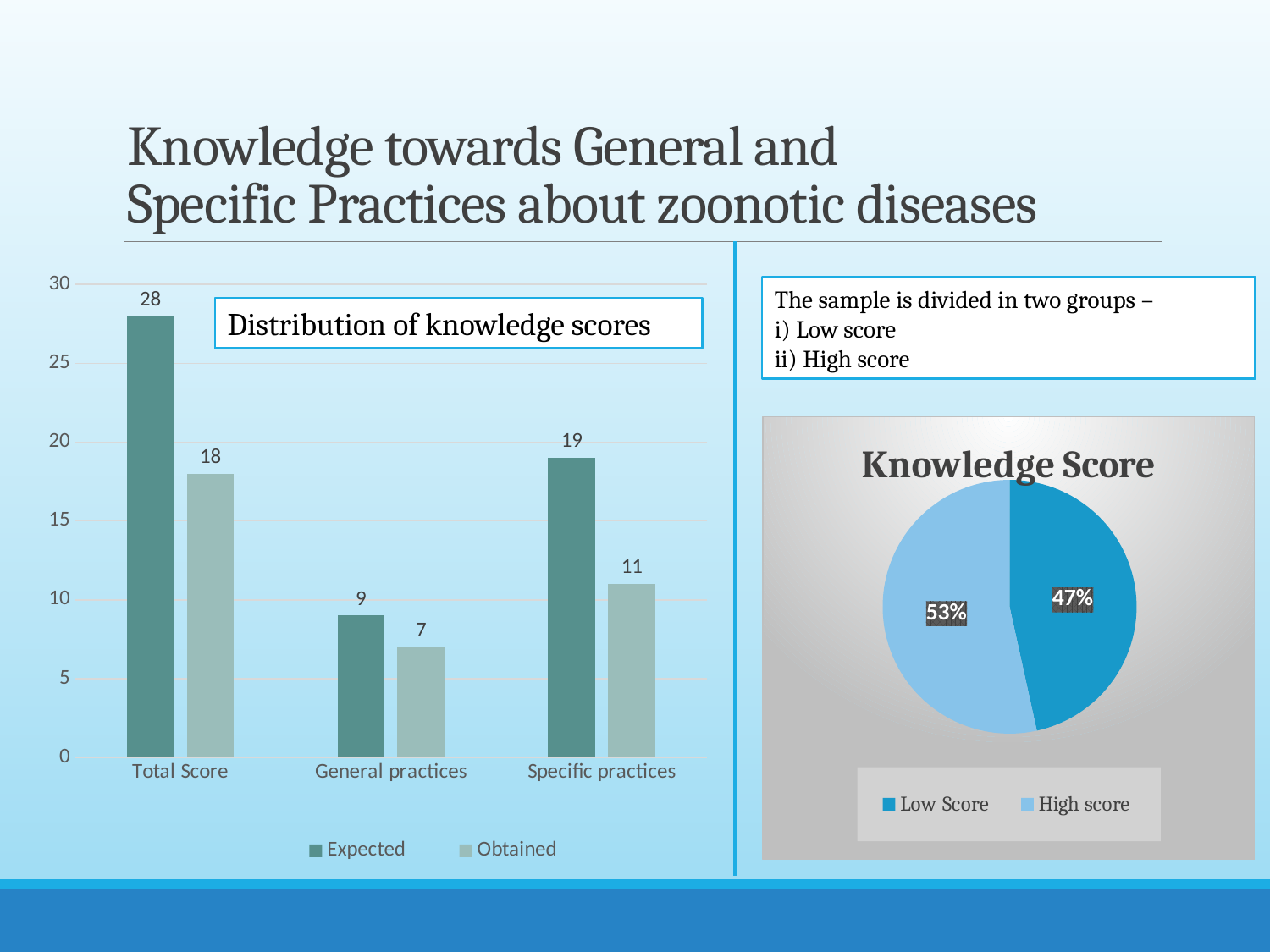
In the 'Distribution of knowledge scores' chart, what is the Expected value for Total Score? 28 In the 'Distribution of knowledge scores' chart, how many series does the legend list? 2 In the 'Distribution of knowledge scores' chart, what is the Obtained value for General practices? 7 In the 'Distribution of knowledge scores' chart, what is the difference between the Expected and Obtained values for Total Score? 10 In the 'Distribution of knowledge scores' chart, what is the Obtained value for Specific practices? 11 What kind of chart is the 'Distribution of knowledge scores' chart? Bar chart In the 'Knowledge Score' pie chart, what share is Low Score? 47% In the 'Knowledge Score' pie chart, which slice is larger, Low Score or High score? High score In the 'Distribution of knowledge scores' chart, is the Expected value for Specific practices larger or the Obtained value for Total Score? Expected value for Specific practices In the 'Distribution of knowledge scores' chart, which category has the highest Expected value? Total Score In the 'Distribution of knowledge scores' chart, which category has the lowest Obtained value? General practices In the 'Distribution of knowledge scores' chart, how many categories are shown on the x axis? 3